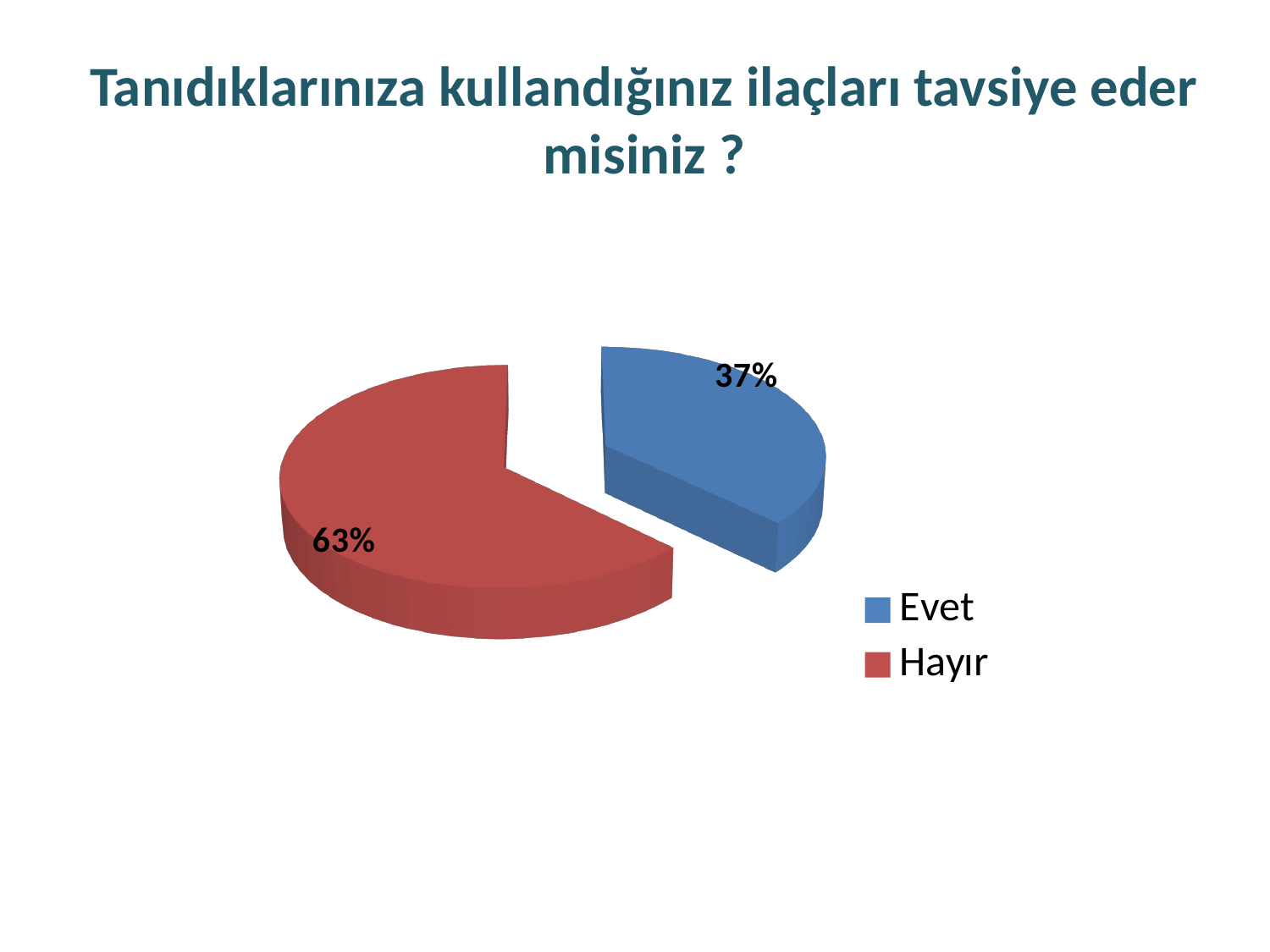
What kind of chart is shown on the slide? pie chart What colour is the Hayır slice? red What share of the pie does Hayır represent? 63% Which is larger, Evet or Hayır? Hayır How many entries does the legend list? 2 What is the difference in percentage points between Hayır and Evet? 26 Which slice is the smallest? Evet What is the title of the slide? Tanıdıklarınıza kullandığınız ilaçları tavsiye eder misiniz ? Which slice is the largest? Hayır How many slices does the pie chart have? 2 What share of the pie does Evet represent? 37%